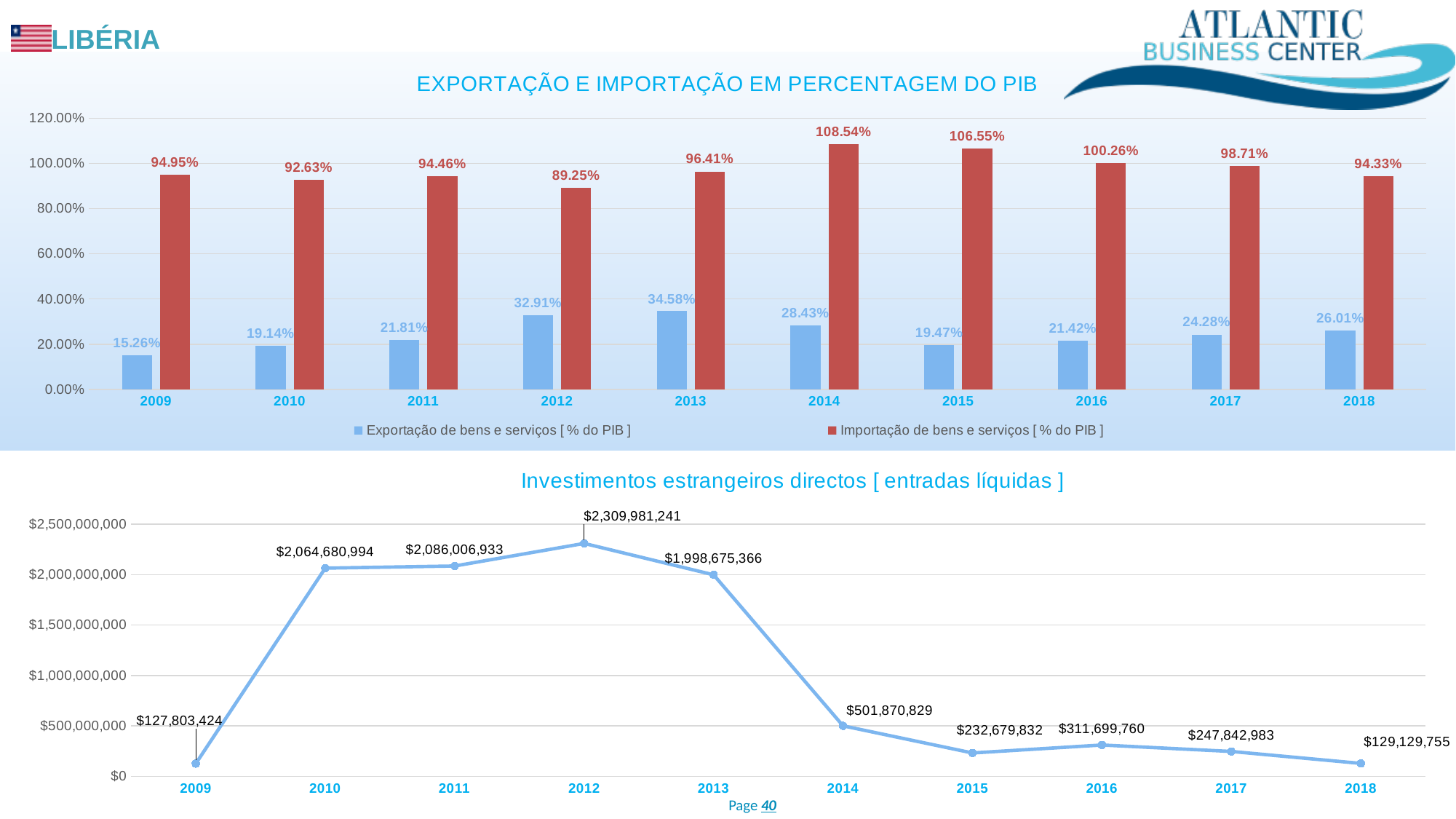
In the chart 'EXPORTAÇÃO E IMPORTAÇÃO EM PERCENTAGEM DO PIB', what is the value of Importação de bens e serviços for 2012? 89.25% In the chart 'EXPORTAÇÃO E IMPORTAÇÃO EM PERCENTAGEM DO PIB', which year has the highest Importação de bens e serviços value? 2014 In the chart 'Investimentos estrangeiros directos [ entradas líquidas ]', is the value for 2015 larger or smaller than the value for 2016? Smaller In the chart 'EXPORTAÇÃO E IMPORTAÇÃO EM PERCENTAGEM DO PIB', which year has the lowest Exportação de bens e serviços value? 2009 In the chart 'EXPORTAÇÃO E IMPORTAÇÃO EM PERCENTAGEM DO PIB', what is the value of Exportação de bens e serviços for 2013? 34.58% In the chart 'Investimentos estrangeiros directos [ entradas líquidas ]', what is the value for 2012? $2,309,981,241 In the chart 'EXPORTAÇÃO E IMPORTAÇÃO EM PERCENTAGEM DO PIB', how many series does the legend list? 2 In the chart 'EXPORTAÇÃO E IMPORTAÇÃO EM PERCENTAGEM DO PIB', what is the difference between Importação and Exportação in 2014? 80.11% In the chart 'Investimentos estrangeiros directos [ entradas líquidas ]', what is the difference between the 2012 and 2013 values? $311,305,875 In the chart 'Investimentos estrangeiros directos [ entradas líquidas ]', how many years are plotted? 10 What type of chart is 'EXPORTAÇÃO E IMPORTAÇÃO EM PERCENTAGEM DO PIB'? Bar chart In the chart 'Investimentos estrangeiros directos [ entradas líquidas ]', which year has the lowest value? 2009